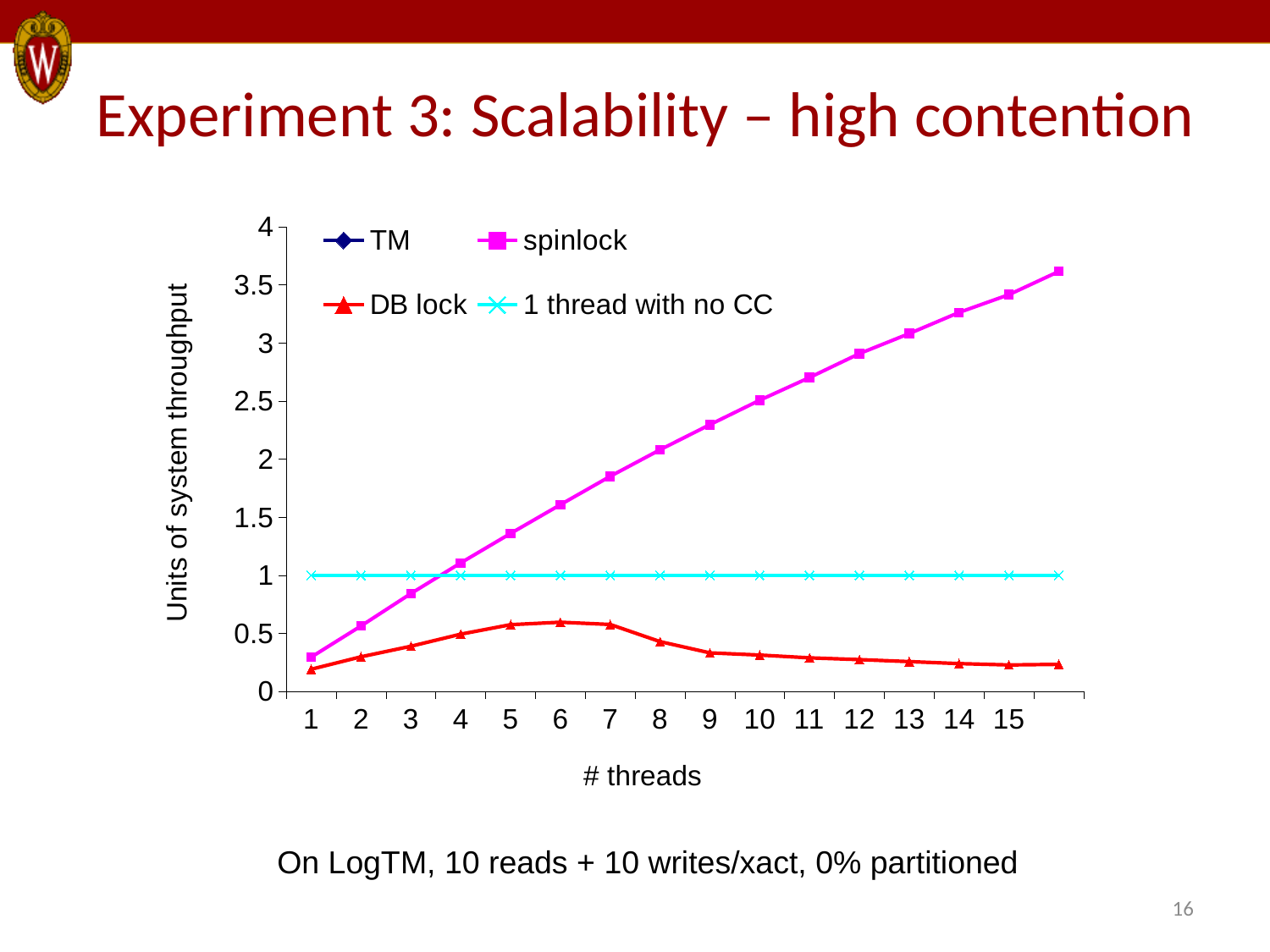
At 2 threads, which is larger: spinlock or 1 thread with no CC? 1 thread with no CC Is the spinlock value at 15 threads greater or less than 3? greater Is the spinlock value at 10 threads greater or less than 2? greater Does the spinlock series rise or fall as the number of threads increases? rises What is the title of the x axis? # threads How many series does the legend list? 4 What is the value of the '1 thread with no CC' series at 5 threads? 1 Is the DB lock value at 15 threads greater or less than 0.5? less What kind of chart is shown on the slide? line chart At 10 threads, which is larger: spinlock or DB lock? spinlock Does the DB lock series rise or fall from 7 threads to 15 threads? falls